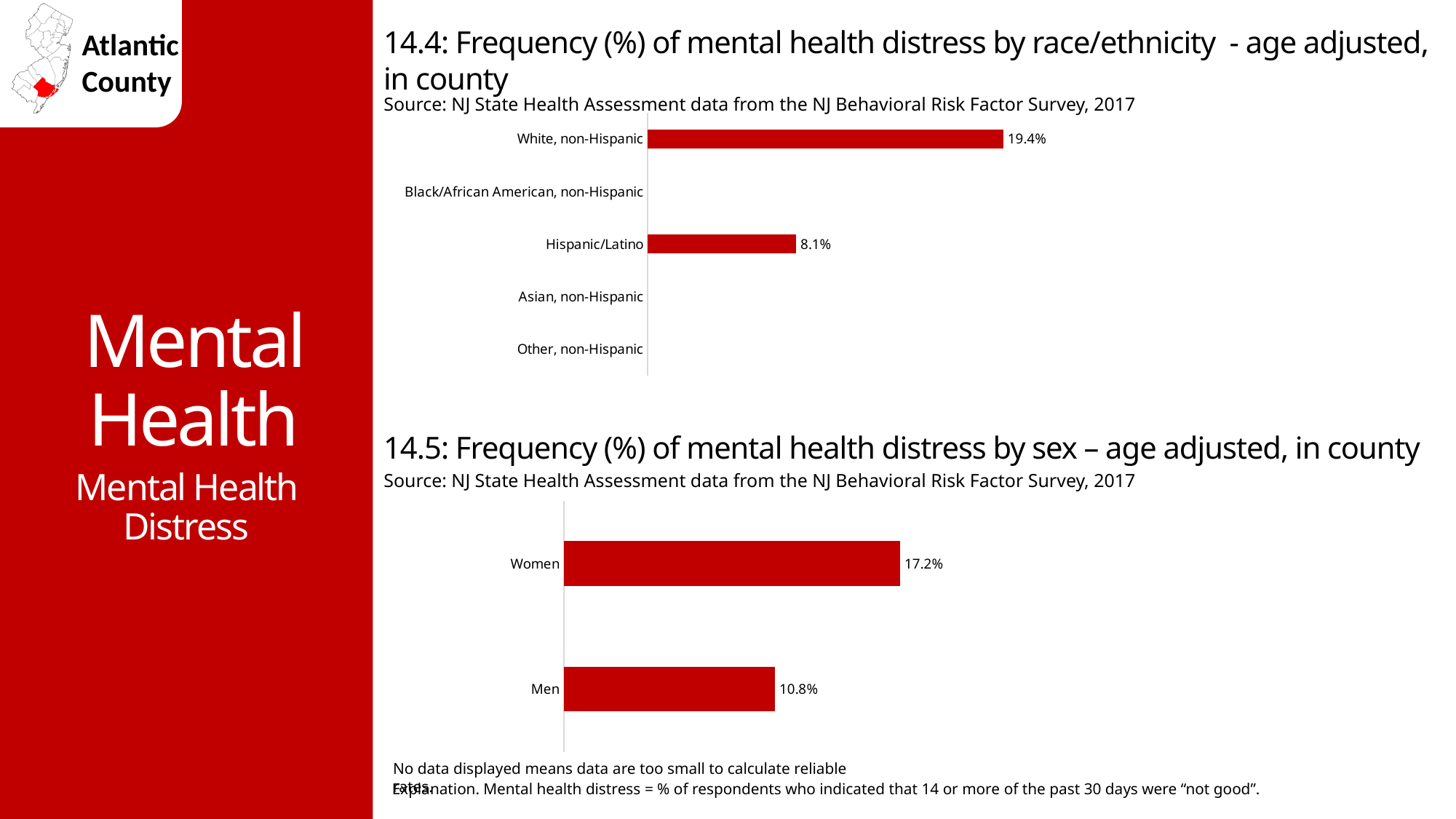
In chart 14.4 (mental health distress by race/ethnicity), what is the value for Hispanic/Latino? 8.1% In chart 14.4 (mental health distress by race/ethnicity), how many race/ethnicity categories are listed on the axis? 5 In chart 14.4 (mental health distress by race/ethnicity), how many categories have a bar displayed? 2 Which is larger: the value for White, non-Hispanic in chart 14.4 or the value for Women in chart 14.5? White, non-Hispanic in chart 14.4 In chart 14.4 (mental health distress by race/ethnicity), which category has the highest value? White, non-Hispanic What type of chart is chart 14.5 (mental health distress by sex)? Bar chart In chart 14.5 (mental health distress by sex), what is the value for Men? 10.8% In chart 14.4 (mental health distress by race/ethnicity), what is the value for White, non-Hispanic? 19.4% In chart 14.5 (mental health distress by sex), which group has the lower value? Men In chart 14.4 (mental health distress by race/ethnicity), what is the difference between the White, non-Hispanic and Hispanic/Latino values? 11.3% In chart 14.5 (mental health distress by sex), what is the value for Women? 17.2% In chart 14.5 (mental health distress by sex), what is the difference between the Women and Men values? 6.4%